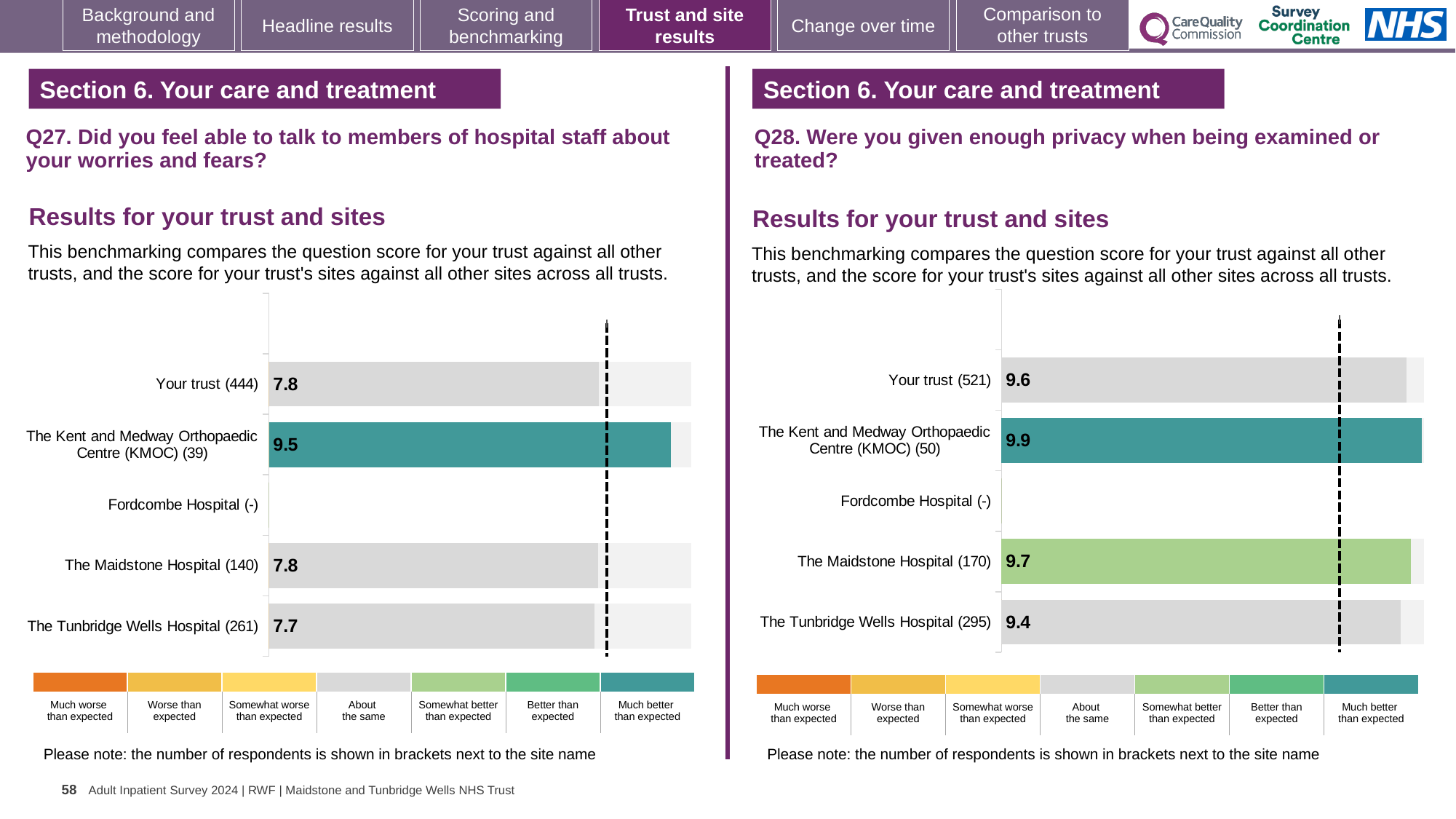
On the Q28 chart (right), what is the score for The Maidstone Hospital (170)? 9.7 What kind of chart is used on the Q27 chart (left)? bar chart On the Q27 chart (left), what is the score for The Kent and Medway Orthopaedic Centre (KMOC) (39)? 9.5 On the Q28 chart (right), which site has the lowest score among those with a score shown? The Tunbridge Wells Hospital (295) On the Q27 chart (left), what is the score for Your trust (444)? 7.8 On the Q27 chart (left), which site has no score shown? Fordcombe Hospital (-) On the Q28 chart (right), which benchmark category does the colour of The Maidstone Hospital bar represent? Somewhat better than expected On the Q27 chart (left), which site has the highest score? The Kent and Medway Orthopaedic Centre (KMOC) (39) On the Q28 chart (right), what is the score for The Tunbridge Wells Hospital (295)? 9.4 On the Q28 chart (right), is the score for Your trust (521) larger or smaller than the score for The Kent and Medway Orthopaedic Centre (KMOC) (50)? smaller On the Q27 chart (left), what is the difference between the scores for The Kent and Medway Orthopaedic Centre (KMOC) and The Tunbridge Wells Hospital? 1.8 On the Q28 chart (right), what is the difference between the scores for The Kent and Medway Orthopaedic Centre (KMOC) and Your trust? 0.3